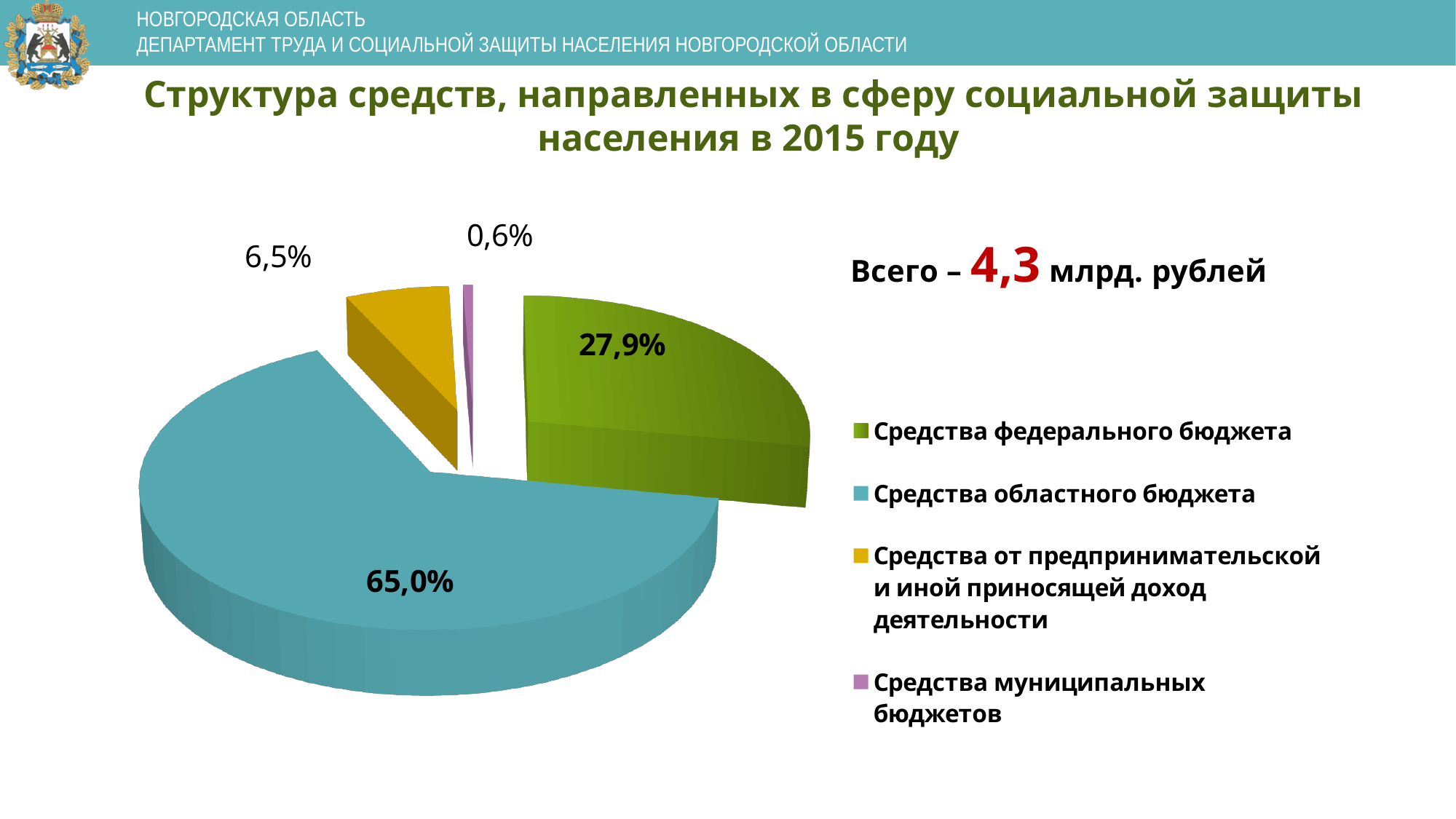
How many categories does the pie chart show? 4 What share of the pie is labelled for Средства муниципальных бюджетов? 0,6% What share of the pie is labelled for Средства от предпринимательской и иной приносящей доход деятельности? 6,5% Which is larger: the share for Средства федерального бюджета or the share for Средства от предпринимательской и иной приносящей доход деятельности? Средства федерального бюджета What colour is the slice for Средства от предпринимательской и иной приносящей доход деятельности? Yellow What total amount is stated next to the chart? 4,3 млрд. рублей Which category has the largest slice of the pie? Средства областного бюджета What share of the pie is labelled for Средства областного бюджета? 65,0% What share of the pie is labelled for Средства федерального бюджета? 27,9% What is the difference in percentage points between Средства областного бюджета and Средства федерального бюджета? 37,1 What kind of chart is shown on the slide? Pie chart Which category has the smallest slice of the pie? Средства муниципальных бюджетов